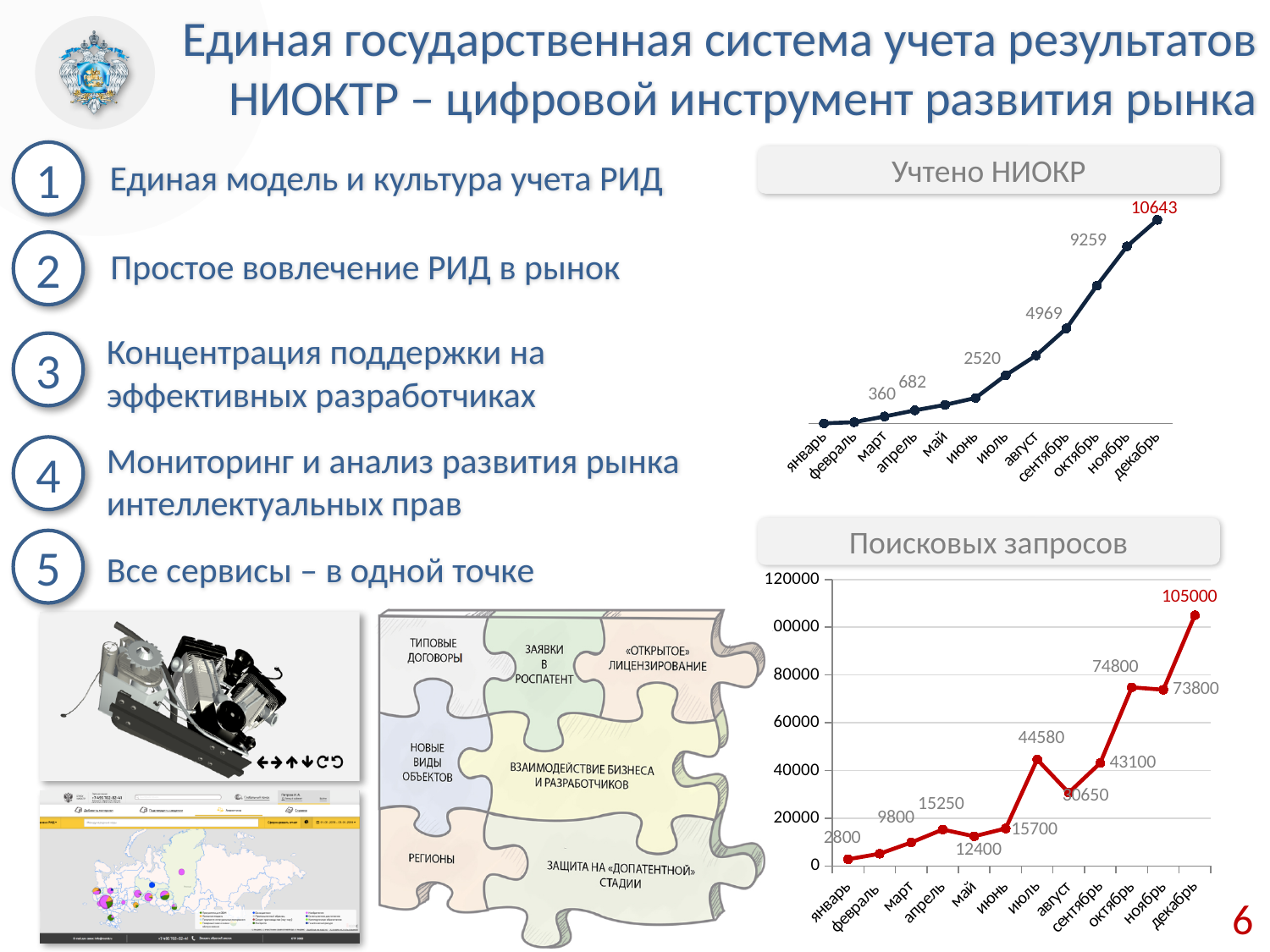
In the 'Поисковых запросов' chart, which month has the lowest value? январь What kind of chart is the 'Поисковых запросов' chart? line chart In the 'Учтено НИОКР' chart, do the values rise or fall from январь to декабрь? rise In the 'Поисковых запросов' chart, what is the value for декабрь? 105000 In the 'Поисковых запросов' chart, what is the value for январь? 2800 In the 'Поисковых запросов' chart, is the value for февраль greater or less than 20000? less In the 'Поисковых запросов' chart, what is the difference between the values for декабрь and ноябрь? 31200 How many months are plotted in the 'Поисковых запросов' chart? 12 In the 'Поисковых запросов' chart, which month has the highest value? декабрь In the 'Поисковых запросов' chart, what is the value for июль? 44580 In the 'Учтено НИОКР' chart, what is the value for декабрь? 10643 In the 'Поисковых запросов' chart, which is larger, the value for октябрь or the value for ноябрь? октябрь